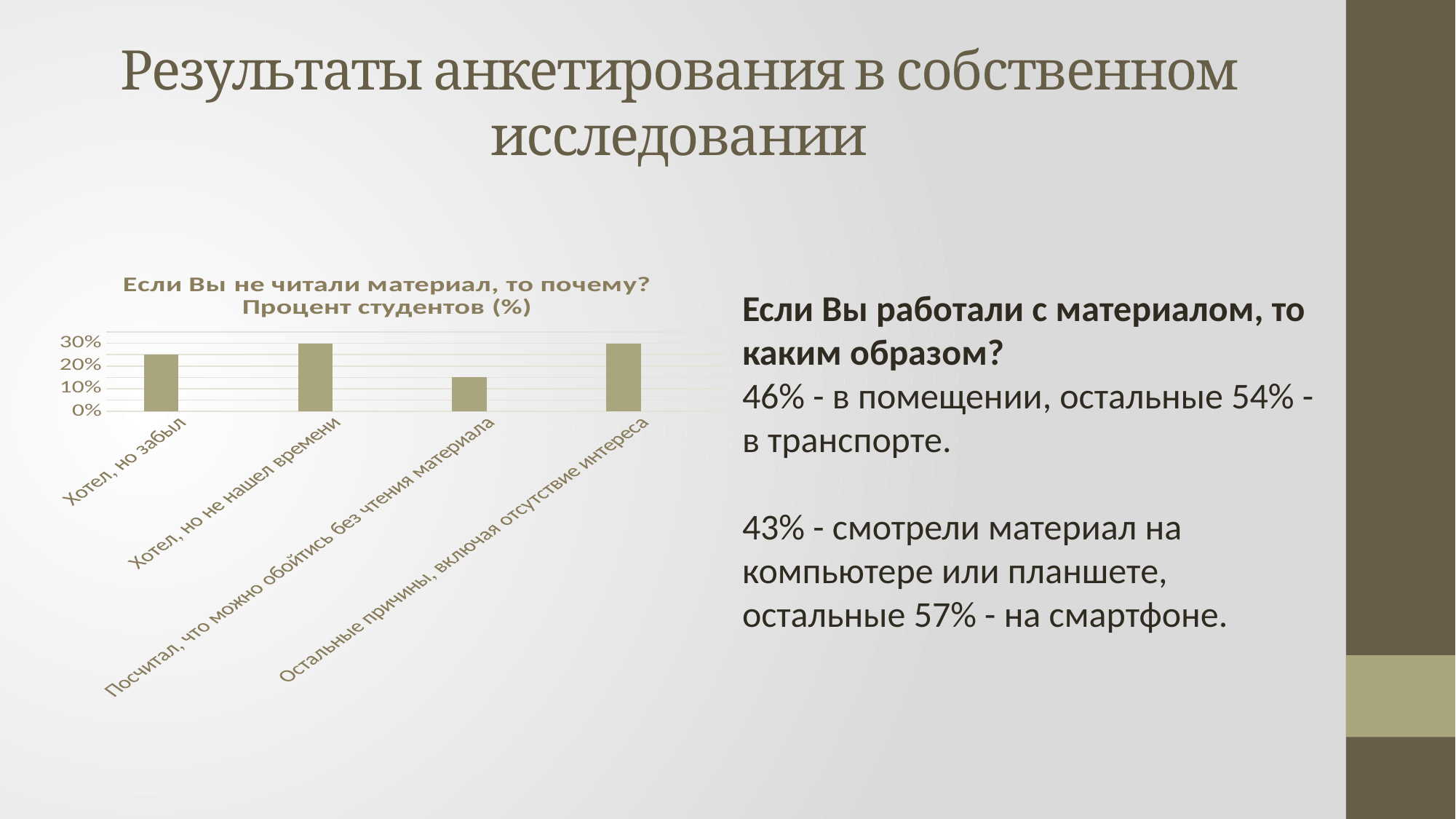
Which category has the lowest value in the chart? Посчитал, что можно обойтись без чтения материала Which is larger: the value for "Хотел, но забыл" or for "Посчитал, что можно обойтись без чтения материала"? Хотел, но забыл Is the value for "Посчитал, что можно обойтись без чтения материала" greater or less than 20%? less What kind of chart is shown on the slide? bar chart Is the value for "Хотел, но забыл" greater or less than 20%? greater What is the title of the chart? Если Вы не читали материал, то почему? Процент студентов (%) Is the value for "Посчитал, что можно обойтись без чтения материала" greater or less than 10%? greater What is the highest tick value shown on the vertical axis of the chart? 30% Which is larger: the value for "Хотел, но не нашел времени" or for "Хотел, но забыл"? Хотел, но не нашел времени How many categories are shown in the chart? 4